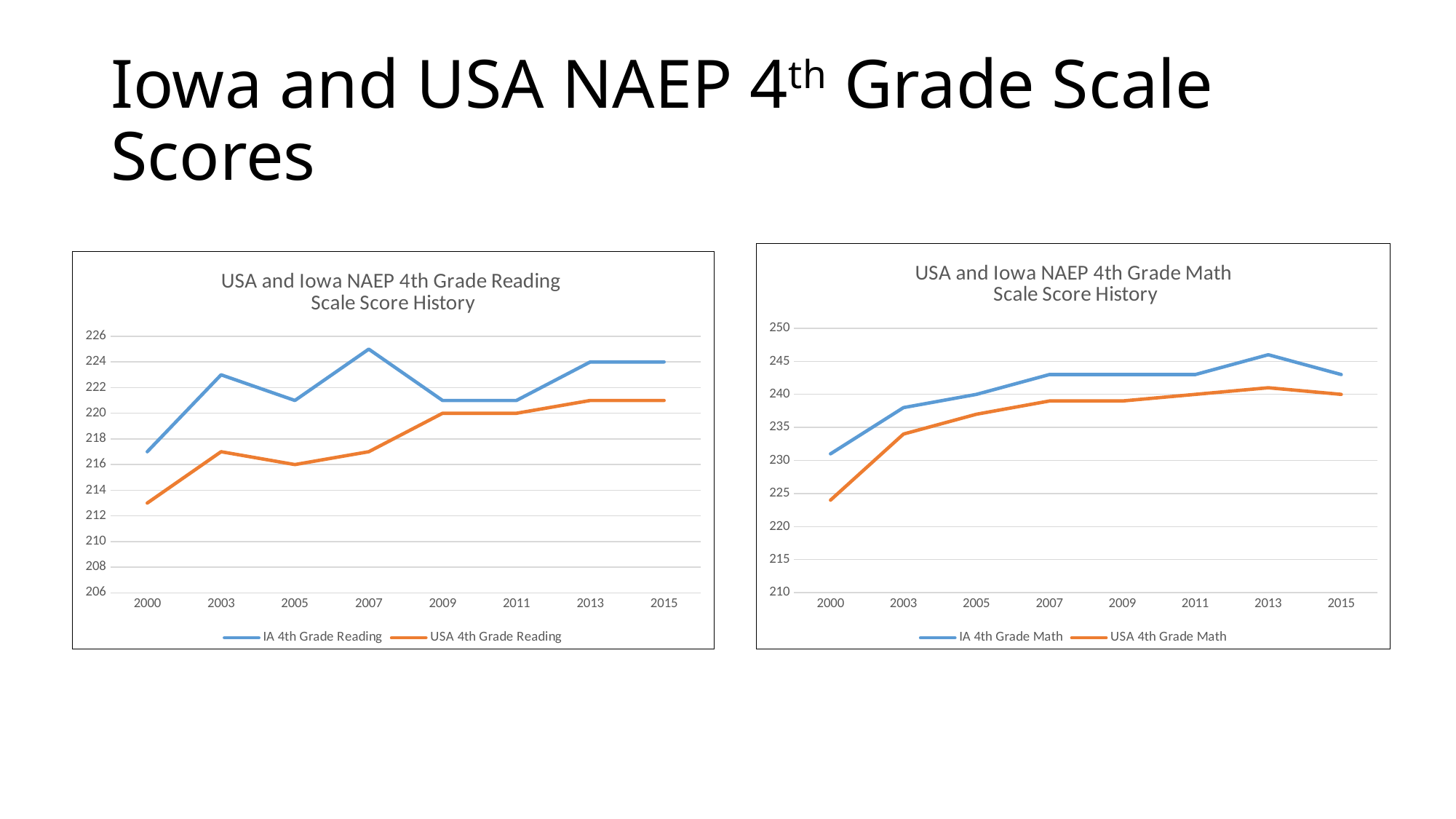
In the USA and Iowa NAEP 4th Grade Math Scale Score History chart, is the IA 4th Grade Math score in 2013 greater or less than 245? greater In the USA and Iowa NAEP 4th Grade Reading Scale Score History chart, which series has the higher score in 2000, IA 4th Grade Reading or USA 4th Grade Reading? IA 4th Grade Reading What kind of chart is the USA and Iowa NAEP 4th Grade Reading Scale Score History chart? line chart In the USA and Iowa NAEP 4th Grade Reading Scale Score History chart, what is the IA 4th Grade Reading score in 2013? 224 In the USA and Iowa NAEP 4th Grade Reading Scale Score History chart, what is the USA 4th Grade Reading score in 2009? 220 In the USA and Iowa NAEP 4th Grade Math Scale Score History chart, what is the IA 4th Grade Math score in 2005? 240 In the USA and Iowa NAEP 4th Grade Reading Scale Score History chart, is the USA 4th Grade Reading score in 2000 greater or less than 214? less How many years are plotted along the x axis of the USA and Iowa NAEP 4th Grade Reading Scale Score History chart? 8 How many series does the legend of the USA and Iowa NAEP 4th Grade Math Scale Score History chart list? 2 In the USA and Iowa NAEP 4th Grade Reading Scale Score History chart, in which year is the IA 4th Grade Reading score highest? 2007 In the USA and Iowa NAEP 4th Grade Math Scale Score History chart, in which year is the USA 4th Grade Math score lowest? 2000 In the USA and Iowa NAEP 4th Grade Math Scale Score History chart, does the USA 4th Grade Math score generally rise or fall from 2000 to 2013? rise